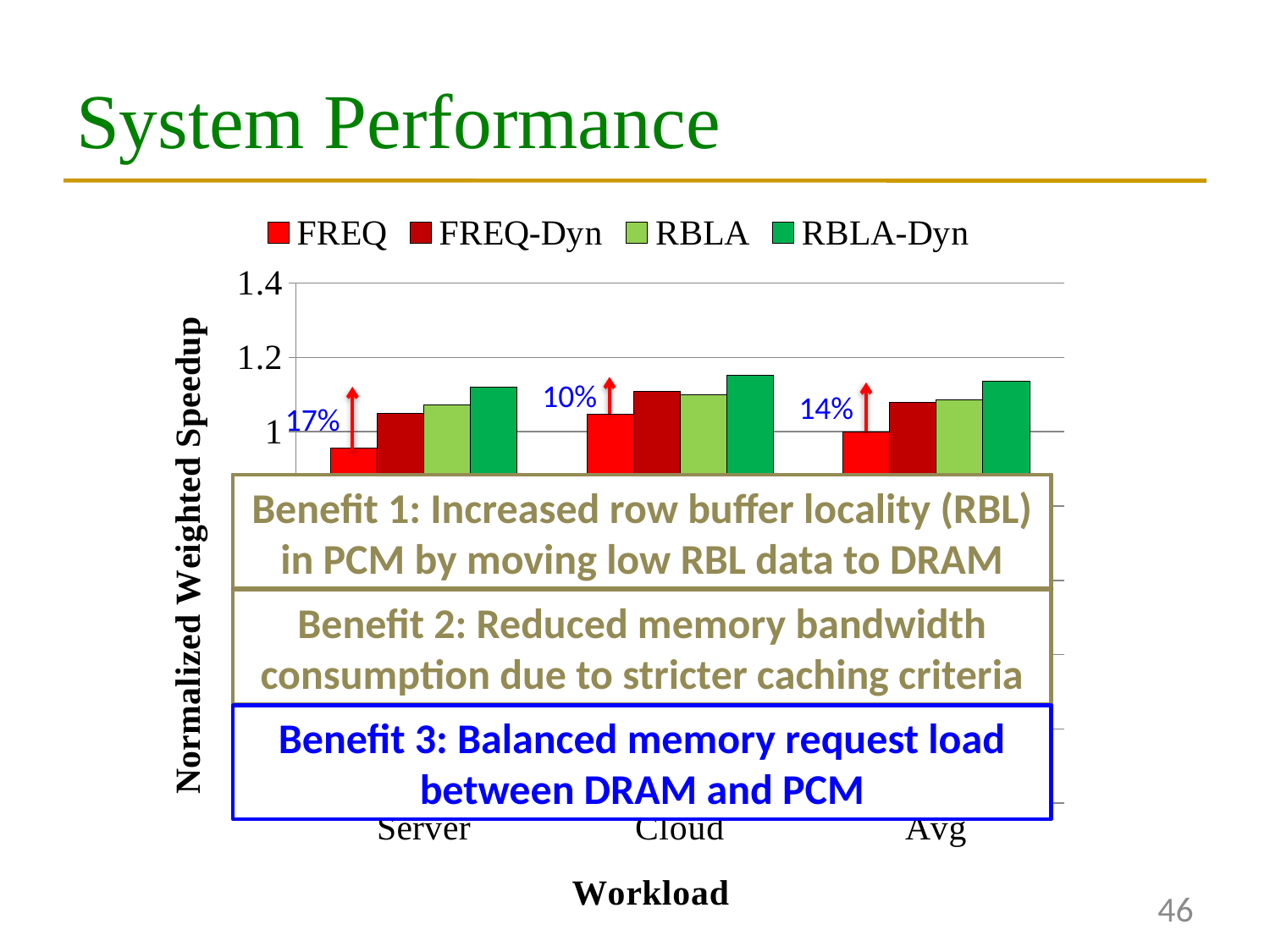
Is the FREQ value for Server greater or less than 1? less How many workload categories are shown on the x axis? 3 For the Avg workload, which is larger: the FREQ bar or the RBLA-Dyn bar? RBLA-Dyn What percentage improvement is annotated above the Server group of bars? 17% How many series does the chart legend list? 4 What percentage improvement is annotated above the Cloud group of bars? 10% Which series has the lowest bar for the Cloud workload? FREQ Which series has the highest bar for the Server workload? RBLA-Dyn What is the title of the chart's y axis? Normalized Weighted Speedup Is the RBLA-Dyn value for Cloud greater or less than 1.2? less What percentage improvement is annotated above the Avg group of bars? 14% What kind of chart is shown on the slide? bar chart